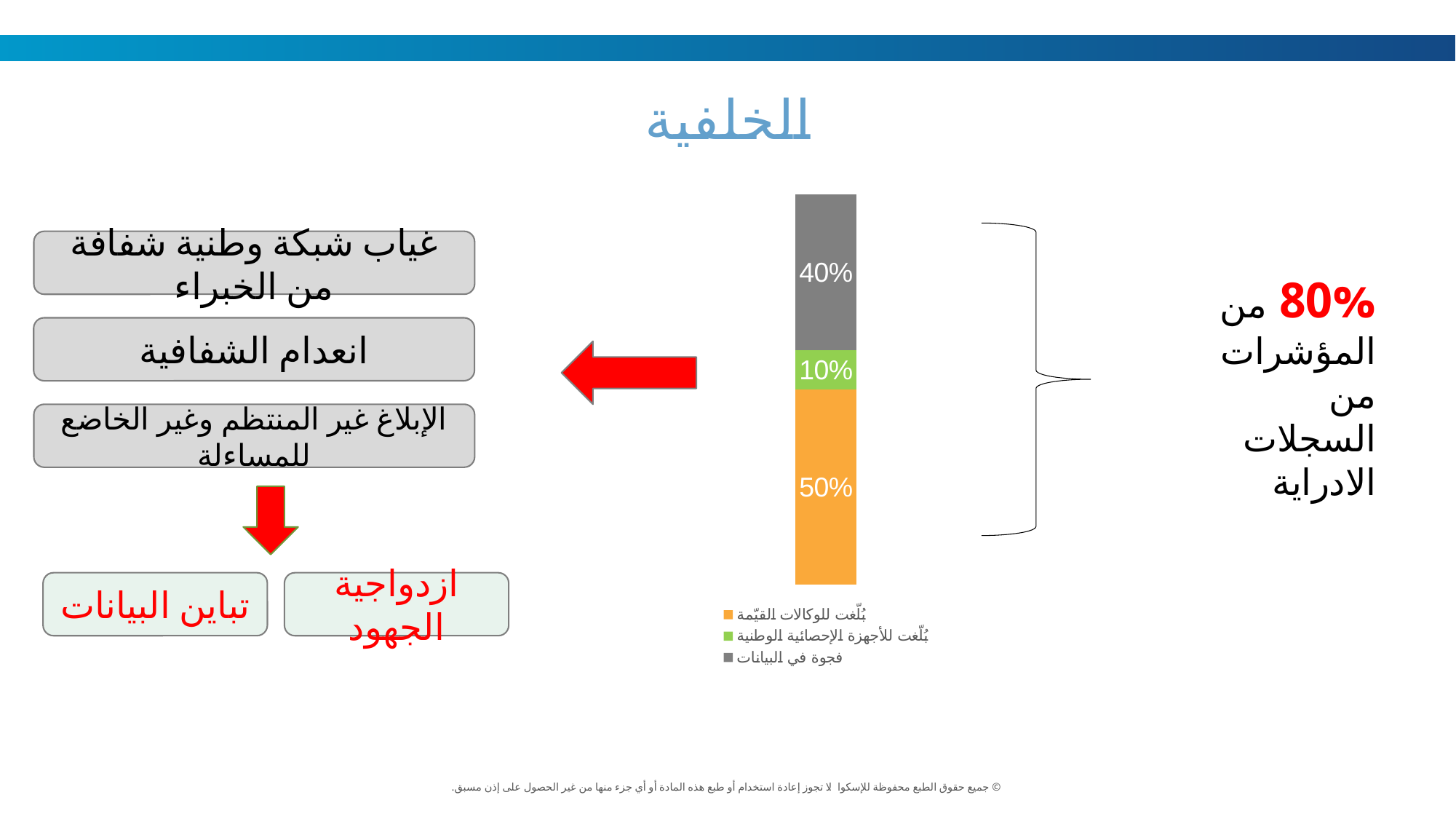
Which segment of the stacked bar is the largest? بُلّغت للوكالات القيّمة Which is larger: the "فجوة في البيانات" segment or the "بُلّغت للوكالات القيّمة" segment? بُلّغت للوكالات القيّمة What is the value of the segment labelled "فجوة في البيانات" (grey)? 40% What kind of chart is shown on the slide? stacked bar chart What is the difference between the "بُلّغت للوكالات القيّمة" segment and the "فجوة في البيانات" segment? 10% What is the difference between the "فجوة في البيانات" segment and the "بُلّغت للأجهزة الإحصائية الوطنية" segment? 30% What is the value of the segment labelled "بُلّغت للأجهزة الإحصائية الوطنية" (green)? 10% Which segment of the stacked bar is the smallest? بُلّغت للأجهزة الإحصائية الوطنية What is the total of the three segments in the stacked bar? 100% How many series does the chart legend list? 3 Which colour represents "فجوة في البيانات" in the chart? grey What is the value of the segment labelled "بُلّغت للوكالات القيّمة" (orange)? 50%